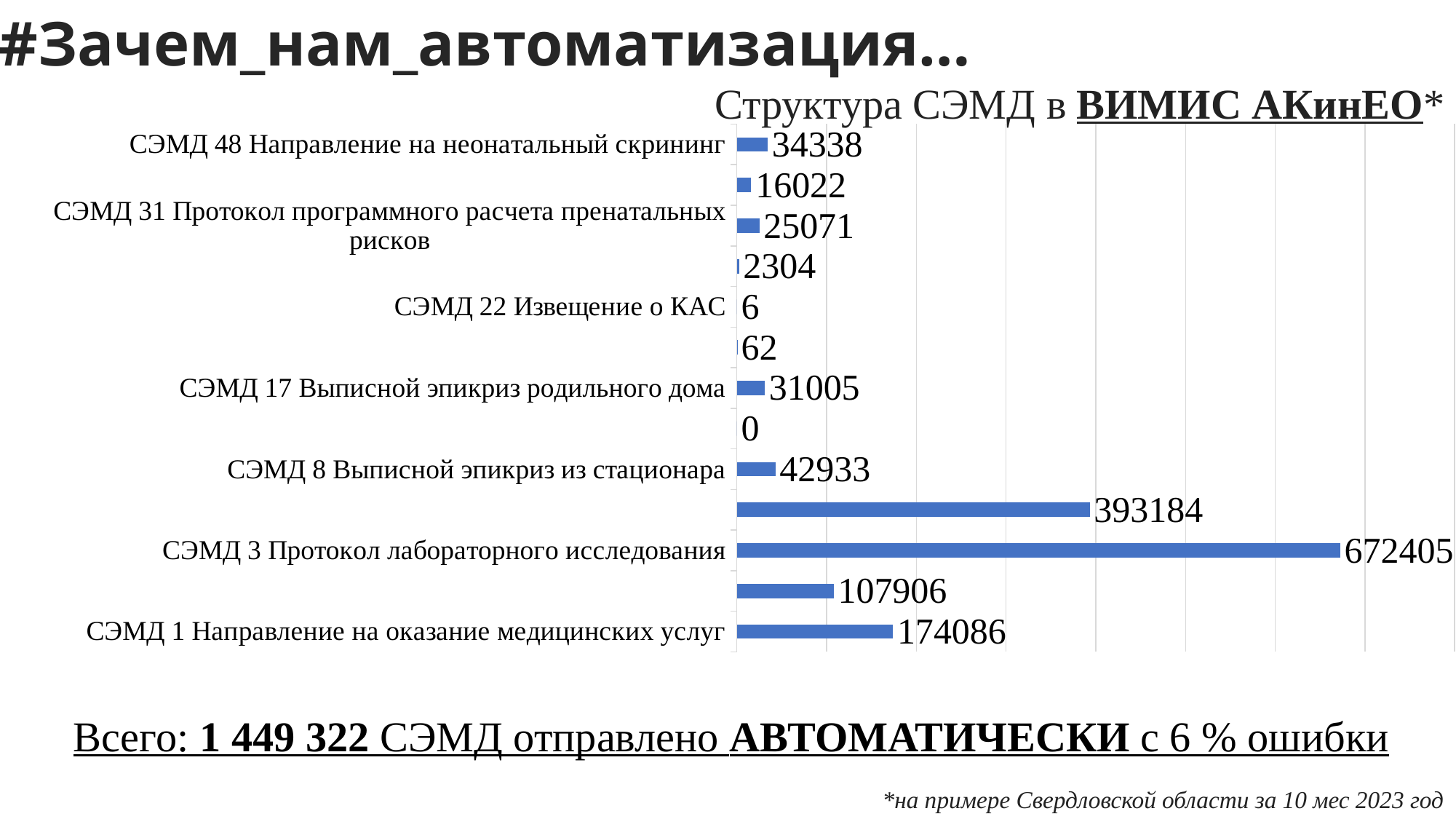
What is the value for СЭМД 8 Выписной эпикриз из стационара? 42933 How many bars are plotted in the chart? 13 Which is larger: the value for СЭМД 17 Выписной эпикриз родильного дома or СЭМД 31 Протокол программного расчета пренатальных рисков? СЭМД 17 Выписной эпикриз родильного дома What is the value for СЭМД 3 Протокол лабораторного исследования? 672405 What is the title of the chart? Структура СЭМД в ВИМИС АКинЕО* What is the value for СЭМД 48 Направление на неонатальный скрининг? 34338 What is the difference between the values for СЭМД 3 Протокол лабораторного исследования and СЭМД 1 Направление на оказание медицинских услуг? 498319 What type of chart is shown on the slide? Bar chart Which category has the highest value? СЭМД 3 Протокол лабораторного исследования What is the value for СЭМД 22 Извещение о КАС? 6 What is the difference between the values for СЭМД 8 Выписной эпикриз из стационара and СЭМД 48 Направление на неонатальный скрининг? 8595 What is the value for СЭМД 1 Направление на оказание медицинских услуг? 174086